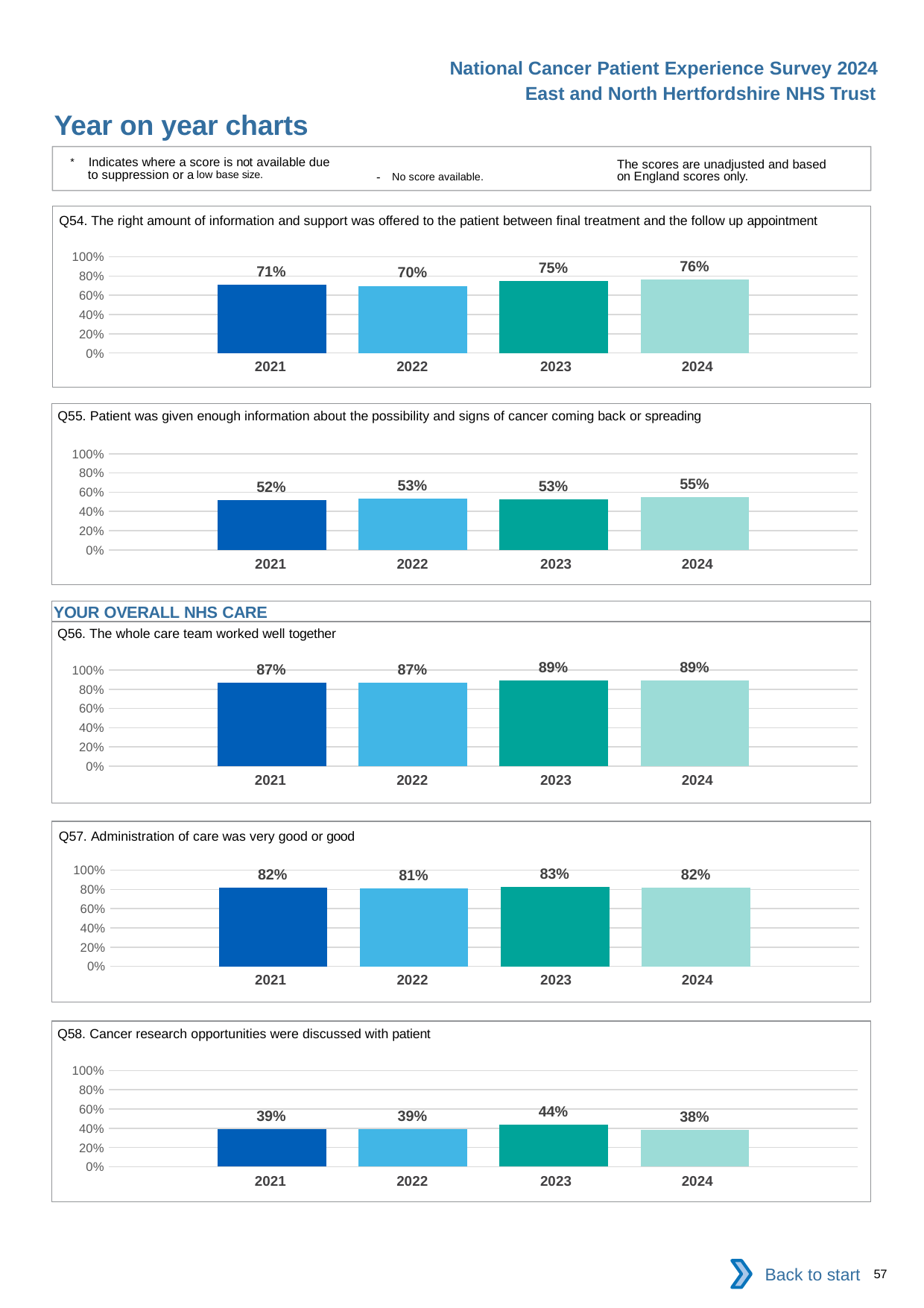
In the Q55 chart, what is the difference between the 2024 value and the 2021 value? 3% In the Q58 chart, is the value for 2023 greater or less than 60%? less What kind of chart is the Q57 chart? bar chart In the Q54 chart, what is the value for 2024? 76% How many charts are on the slide? 5 In the Q57 chart, which is larger, the value for 2022 or the value for 2023? 2023 In the Q56 chart, what is the value for 2021? 87% In the Q58 chart, which year has the lowest value? 2024 In the Q54 chart, what is the difference between the 2024 value and the 2022 value? 6% How many years are shown in the Q58 chart? 4 In the Q58 chart, what is the value for 2023? 44% In the Q55 chart, which year has the highest value? 2024